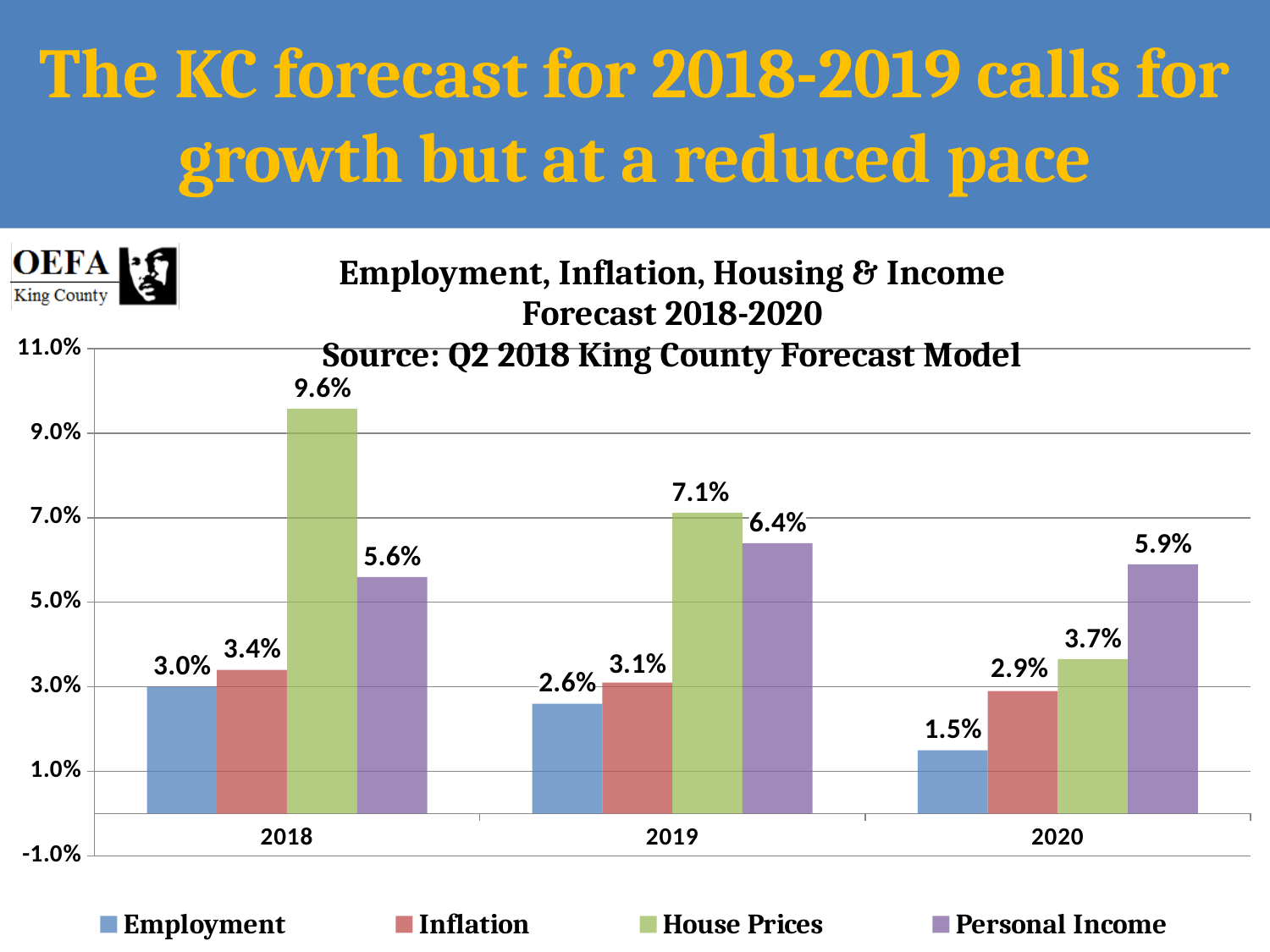
Which series has the highest value in 2018? House Prices What is the difference between the House Prices values for 2018 and 2019? 2.5% What kind of chart is shown on the slide? Bar chart Which is larger in 2020: House Prices or Personal Income? Personal Income What is the forecast value for Inflation in 2020? 2.9% How many series does the legend list? 4 Which series has the lowest value in 2020? Employment What is the forecast value for House Prices in 2018? 9.6% How many years are shown on the x axis? 3 What is the forecast value for Employment in 2020? 1.5% Does the Employment forecast rise or fall from 2018 to 2020? Fall What is the forecast value for Personal Income in 2019? 6.4%